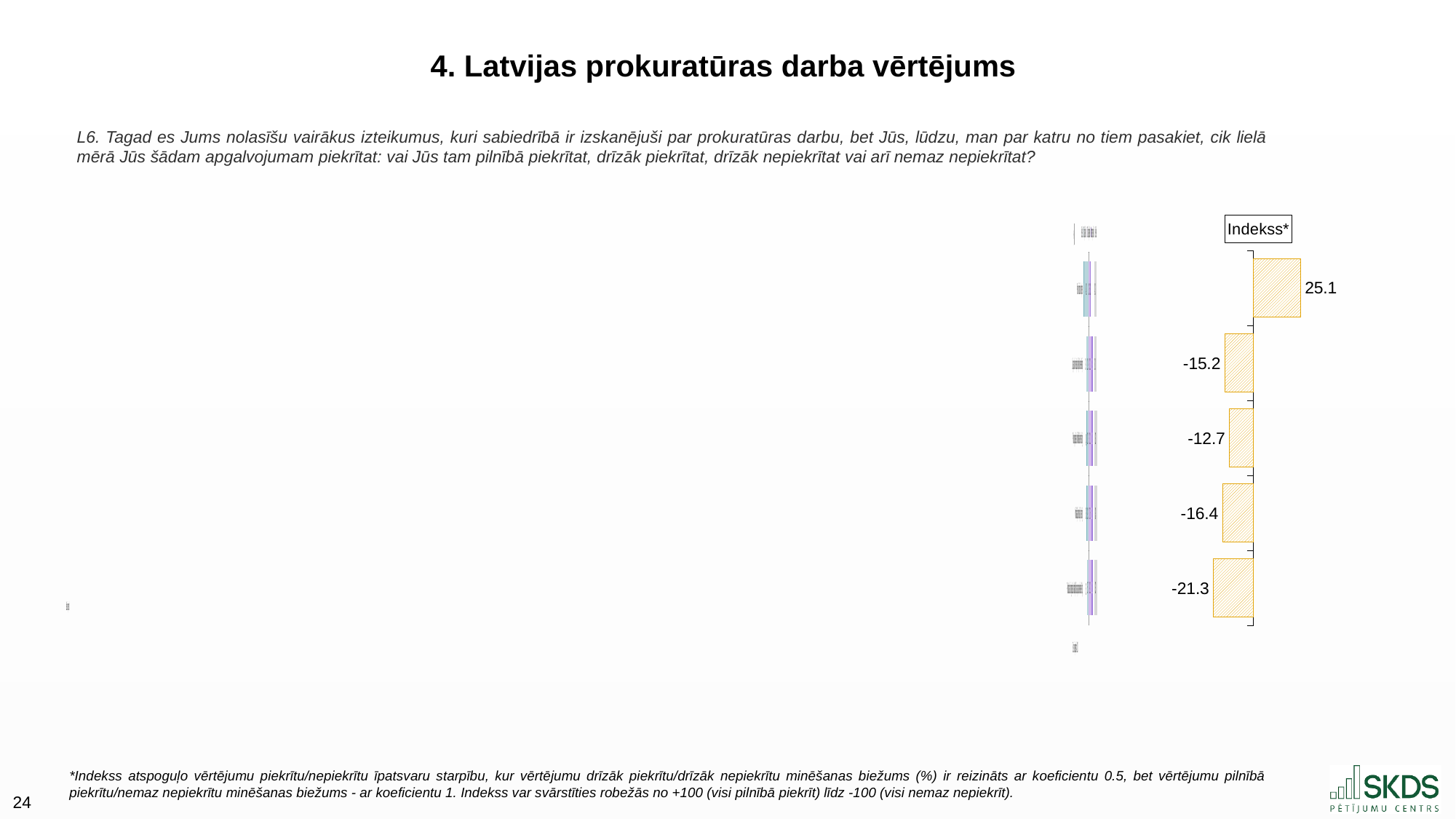
In the Indekss* chart on the right, what is the value of the top bar? 25.1 In the Indekss* chart on the right, which is larger: the second bar from the top (-15.2) or the third bar from the top (-12.7)? -12.7 How many bars are plotted in the Indekss* chart on the right? 5 In the Indekss* chart on the right, what is the value of the fourth bar from the top? -16.4 In the Indekss* chart on the right, what is the lowest value shown? -21.3 In the Indekss* chart on the right, what is the value of the bottom bar? -21.3 In the Indekss* chart on the right, what is the highest value shown? 25.1 What kind of chart is the Indekss* chart on the right? bar chart In the Indekss* chart on the right, what is the difference between the top bar (25.1) and the bottom bar (-21.3)? 46.4 In the Indekss* chart on the right, what is the difference between the third bar (-12.7) and the fourth bar (-16.4)? 3.7 How many bars in the Indekss* chart on the right have negative values? 4 What is the heading shown above the index bar chart on the right of the slide? Indekss*